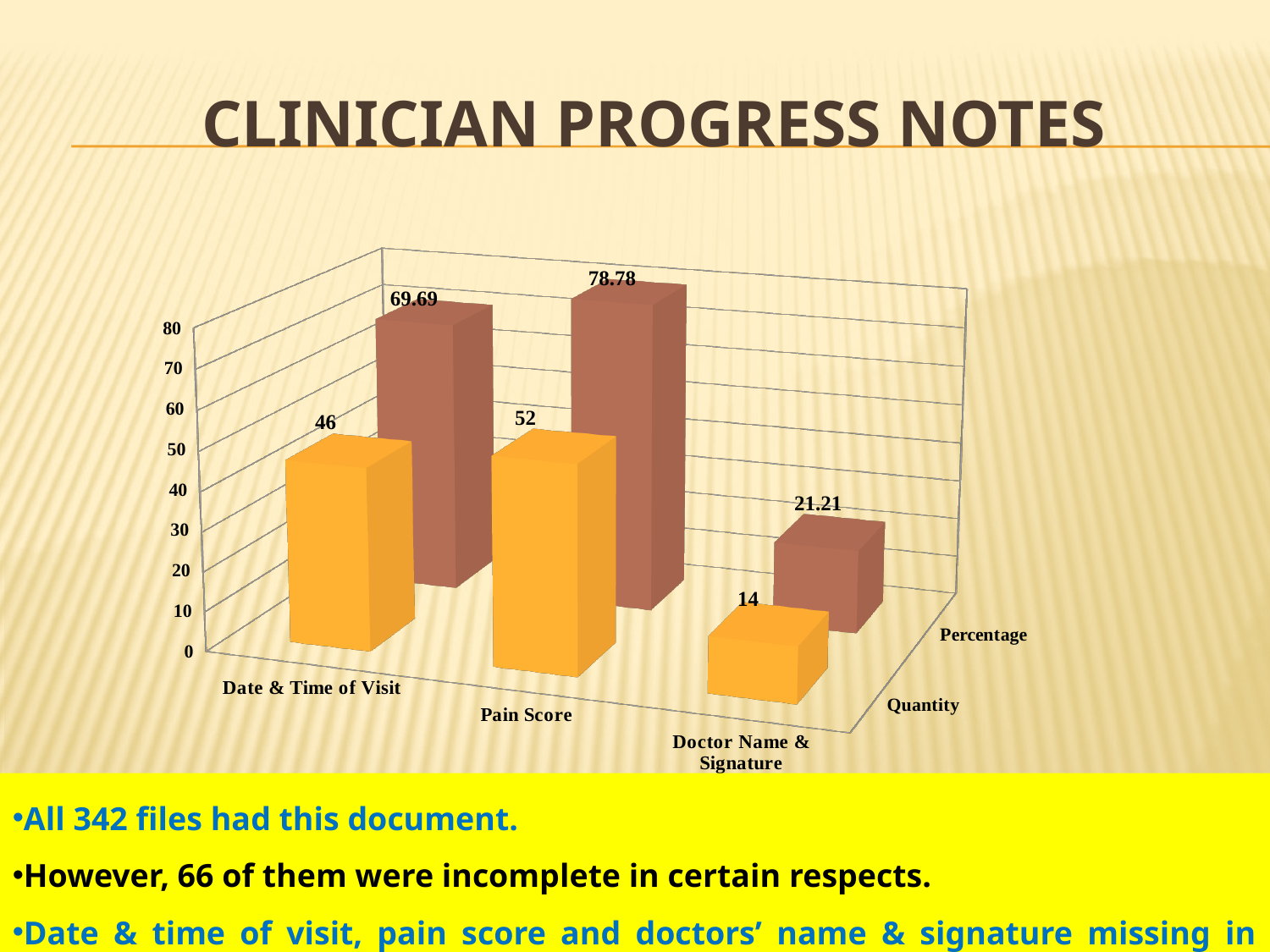
How many series does the chart show? 2 Which category has the lowest Quantity value? Doctor Name & Signature What is the difference between the Quantity values for Pain Score and Date & Time of Visit? 6 What is the Percentage value for Doctor Name & Signature? 21.21 What is the Quantity value for Doctor Name & Signature? 14 What kind of chart is shown on the slide? bar chart Which category has the highest Percentage value? Pain Score Is the Percentage value for Pain Score greater or less than 70? greater What is the Quantity value for Pain Score? 52 Which is larger: the Percentage for Date & Time of Visit or the Percentage for Doctor Name & Signature? Date & Time of Visit What is the Percentage value for Date & Time of Visit? 69.69 How many categories are shown on the chart? 3